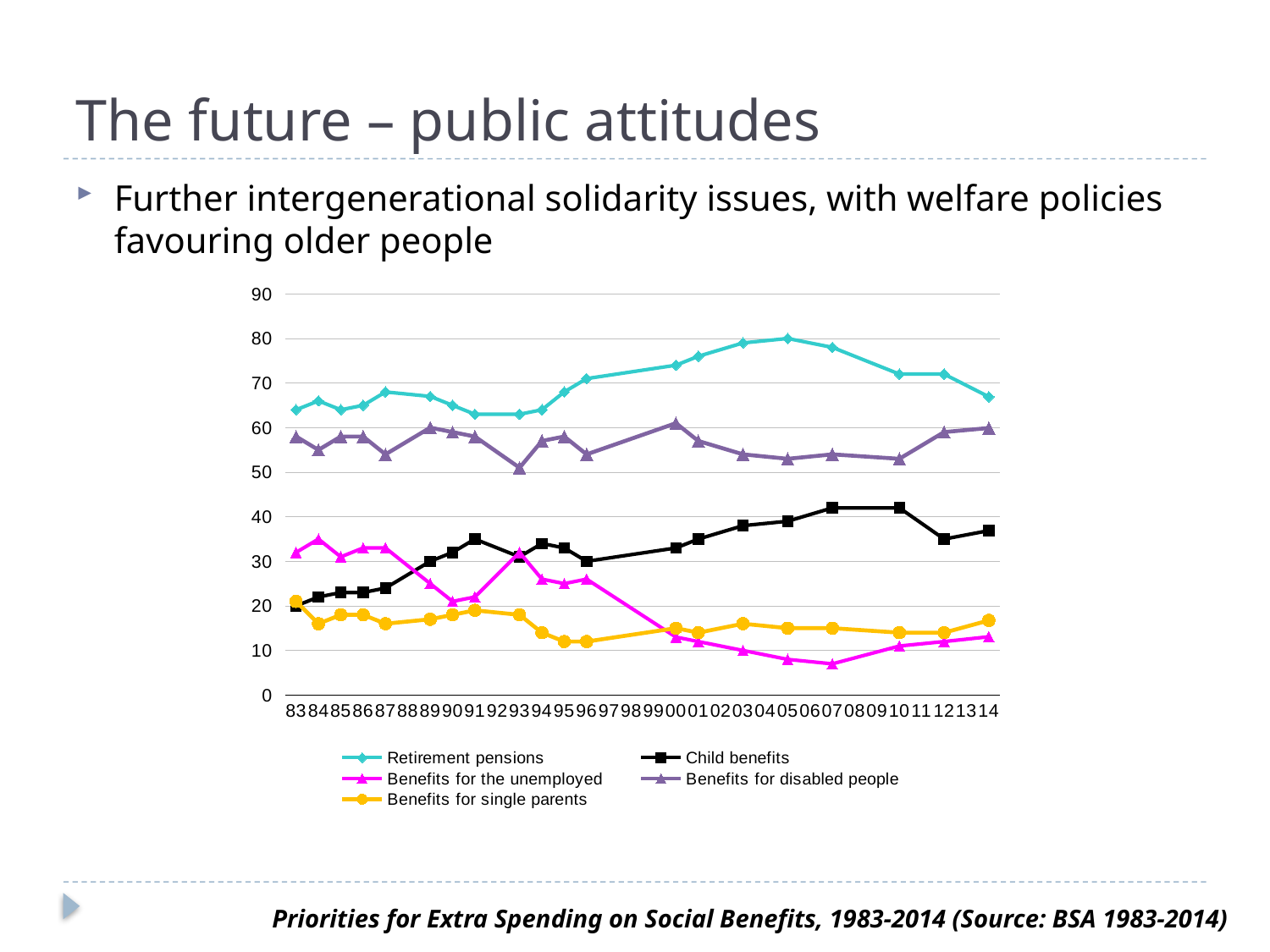
How many series does the legend list? 5 Is the value for Benefits for disabled people in 14 greater or less than 50? greater Do the values for Retirement pensions rise or fall between 05 and 14? fall Which series has the highest values across the whole chart? Retirement pensions Is the value for Retirement pensions in 83 greater or less than 60? greater In 83, which is larger: Retirement pensions or Child benefits? Retirement pensions Is the value for Benefits for the unemployed in 07 greater or less than 10? less Which series reaches the lowest value anywhere on the chart? Benefits for the unemployed What is the caption given for the chart at the bottom of the slide? Priorities for Extra Spending on Social Benefits, 1983-2014 (Source: BSA 1983-2014) In 14, which is larger: Child benefits or Benefits for single parents? Child benefits What kind of chart is shown on the slide? Line chart